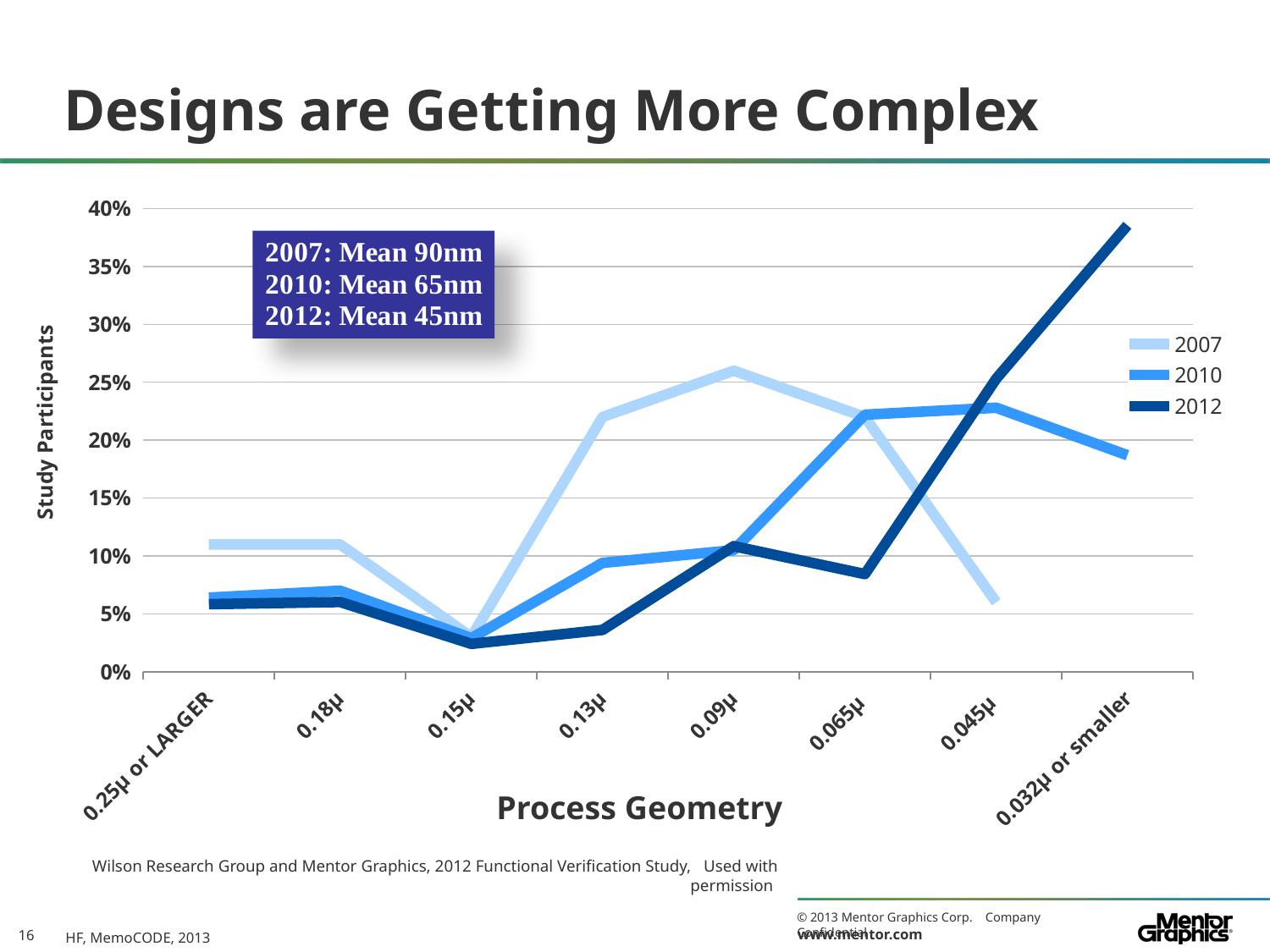
For the 2007 series, which process geometry has the highest share of study participants? 0.09μ For the 2012 series, which process geometry has the highest share of study participants? 0.032μ or smaller Is the 2012 value for 0.032μ or smaller greater or less than 35%? greater What kind of chart is shown on the slide? line chart Does the 2012 series rise or fall from 0.065μ to 0.032μ or smaller? rise For the 2007 series, which process geometry has the lowest share of study participants? 0.15μ How many series does the legend list? 3 What is the title of the x axis? Process Geometry Is the 2010 value for 0.15μ greater or less than 5%? less Is the 2007 value for 0.09μ greater or less than 20%? greater At 0.13μ, which series has the larger value, 2007 or 2012? 2007 How many process geometry categories are shown on the x axis? 8